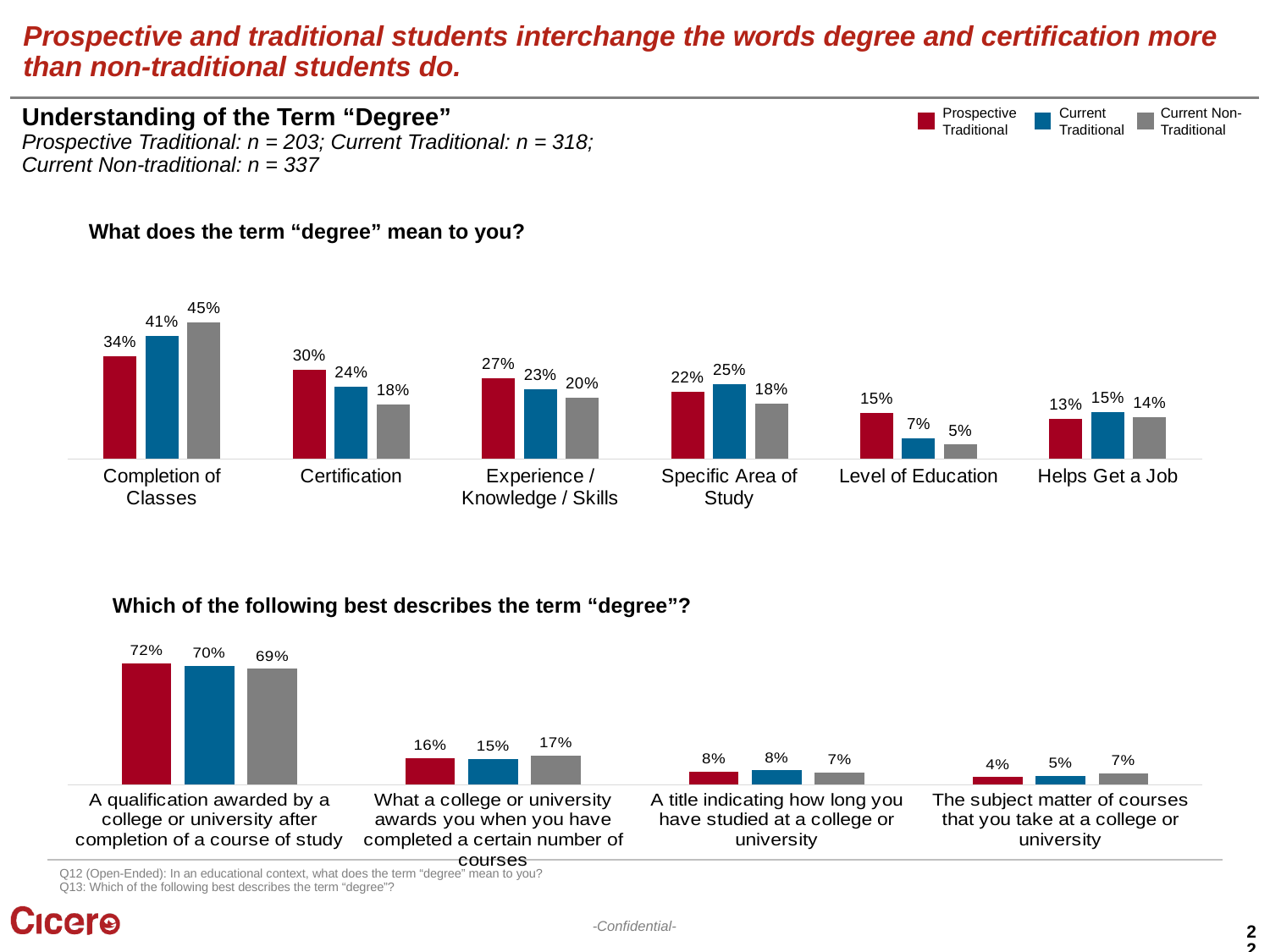
What type of chart is the chart "Which of the following best describes the term "degree"?"? Bar chart How many categories are shown in the chart "Which of the following best describes the term "degree"?"? 4 In the chart "Which of the following best describes the term "degree"?", which category has the highest value for Prospective Traditional students? A qualification awarded by a college or university after completion of a course of study In the chart "What does the term "degree" mean to you?", what is the value for Current Non-Traditional students for Completion of Classes? 45% How many series does the legend list for the charts on this slide? 3 In the chart "What does the term "degree" mean to you?", what is the value for Prospective Traditional students for Certification? 30% In the chart "What does the term "degree" mean to you?", which category has the lowest value for Current Non-Traditional students? Level of Education In the chart "What does the term "degree" mean to you?", which is larger for Specific Area of Study: the Current Traditional value or the Current Non-Traditional value? Current Traditional In the chart "Which of the following best describes the term "degree"?", what is the difference between the Current Non-Traditional and Prospective Traditional values for "The subject matter of courses that you take at a college or university"? 3% In the chart "Which of the following best describes the term "degree"?", what is the Current Traditional value for "A qualification awarded by a college or university after completion of a course of study"? 70% How many categories are shown in the chart "What does the term "degree" mean to you?"? 6 In the chart "What does the term "degree" mean to you?", what is the difference between the Prospective Traditional and Current Traditional values for Level of Education? 8%